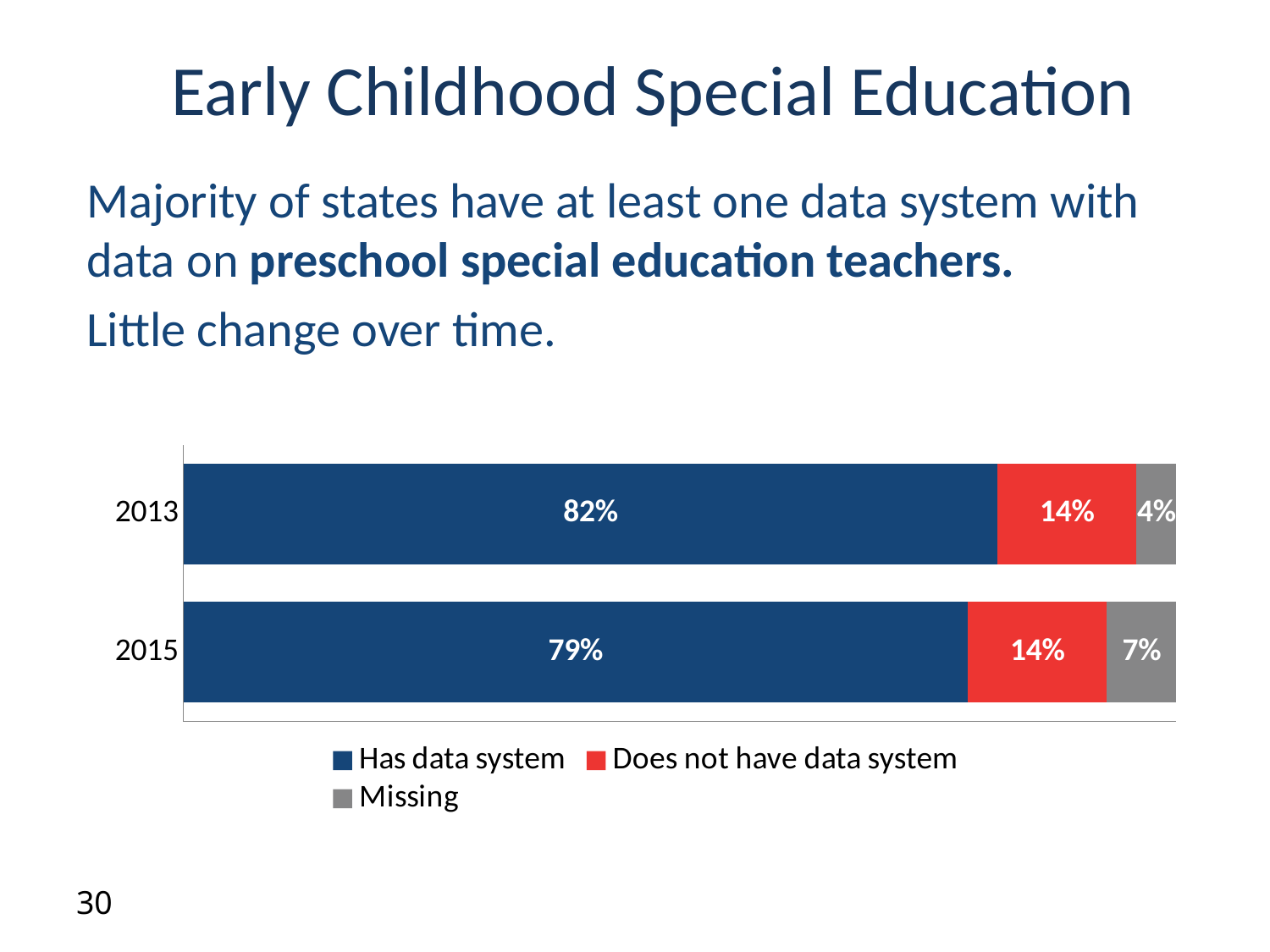
Which year has the higher 'Missing' value? 2015 What percentage of states had a data system in 2015? 79% How many series does the legend list? 3 What is the difference between the 'Has data system' values for 2013 and 2015? 3% What percentage of states had a data system in 2013? 82% How many years are shown on the chart? 2 What is the 'Missing' value for 2015? 7% Which year has the higher 'Has data system' value? 2013 What kind of chart is shown on the slide? Stacked bar chart What is the difference between the 'Missing' values for 2015 and 2013? 3% What is the 'Missing' value for 2013? 4% What is the value for 'Does not have data system' in 2015? 14%